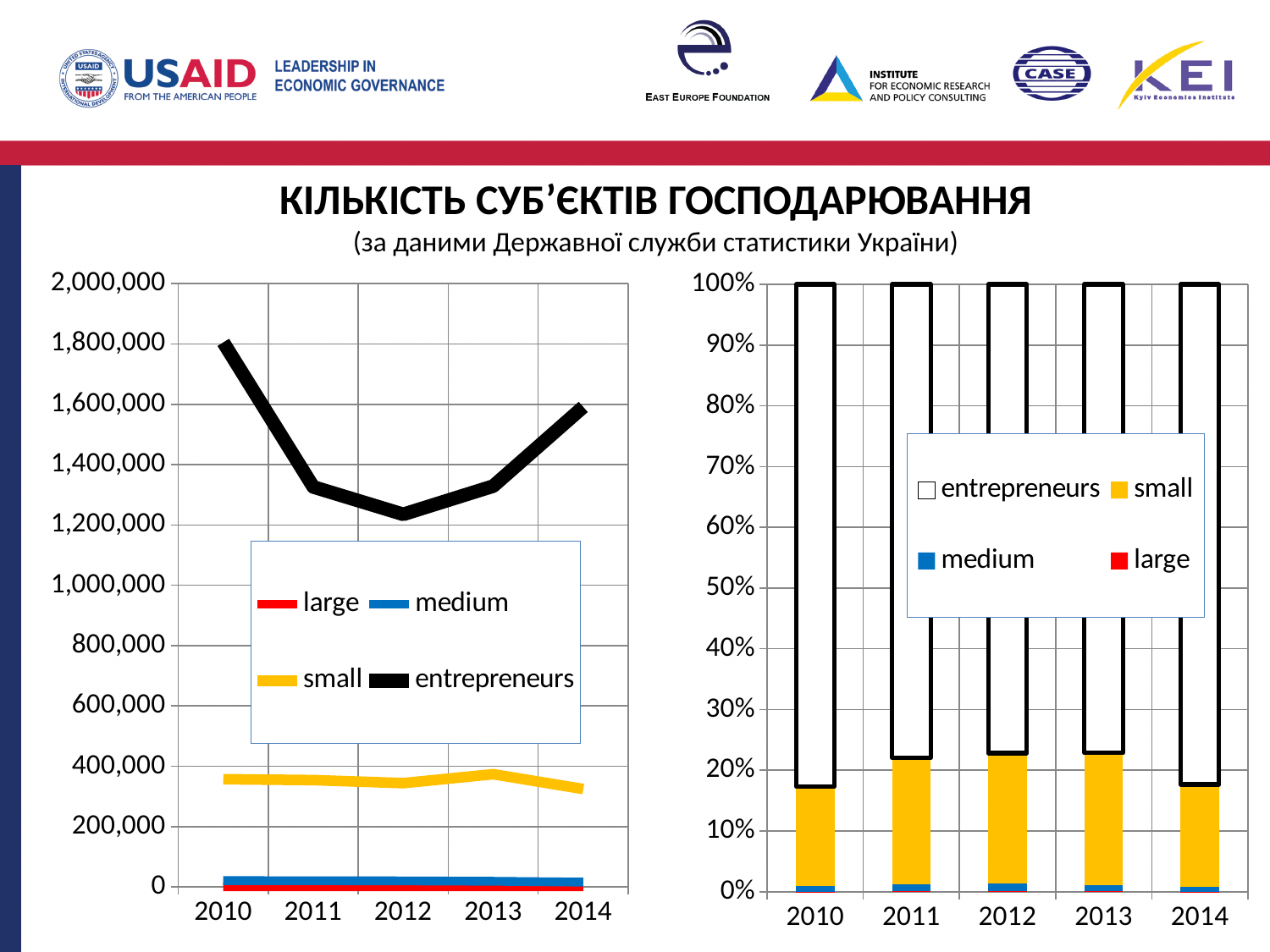
How many years are shown on the x axis of the left chart? 5 What kind of chart is the chart on the left of the slide? line chart In the left chart, is the value for entrepreneurs in 2012 greater or less than 1,400,000? less In the left chart, does the entrepreneurs line rise or fall from 2010 to 2012? fall What kind of chart is the chart on the right of the slide? bar chart In the left chart, in which year is the value for entrepreneurs lowest? 2012 In the left chart, is the value for entrepreneurs in 2010 greater or less than 1,600,000? greater How many series does the legend of the left chart list? 4 What colour represents the small series in the left chart? yellow In the left chart, which year has the larger value for entrepreneurs, 2010 or 2014? 2010 In the left chart, in which year is the value for entrepreneurs highest? 2010 In the right chart, is the share for small in 2012 greater or less than 20%? greater